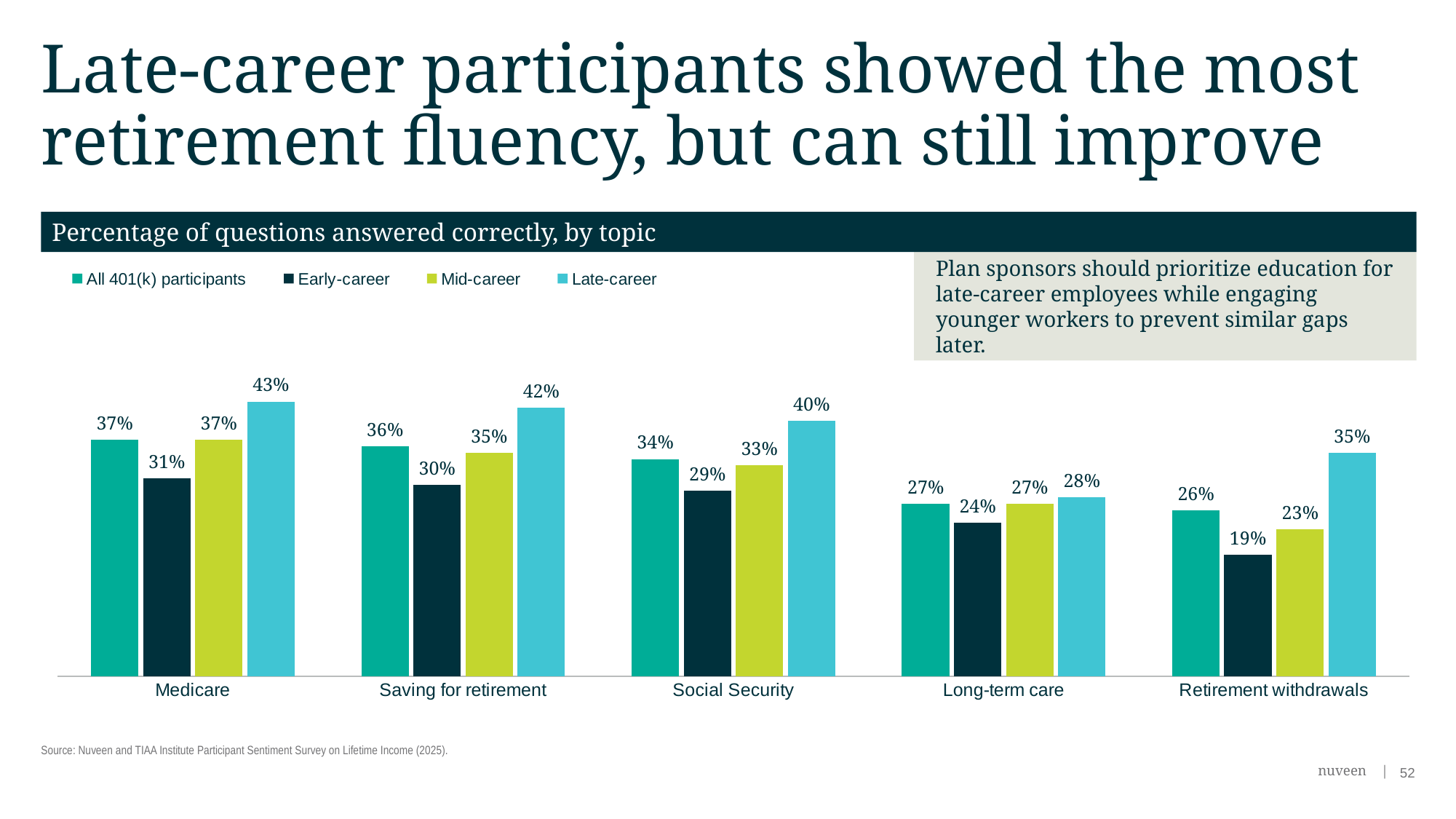
What kind of chart is shown on the slide? Bar chart What is the value for Mid-career participants on Social Security? 33% What percentage of Medicare questions did Late-career participants answer correctly? 43% What is the difference between the Late-career and Mid-career values for Saving for retirement? 7 percentage points Which topic has the highest value for Late-career participants? Medicare What is the value for Early-career participants on Retirement withdrawals? 19% What is the difference between the Late-career and Early-career values for Retirement withdrawals? 16 percentage points How many series does the legend list? 4 What is the value for All 401(k) participants on Long-term care? 27% Which topic has the lowest value for Early-career participants? Retirement withdrawals How many topics are shown on the x axis? 5 Which is larger for Social Security: the value for All 401(k) participants or for Early-career participants? All 401(k) participants